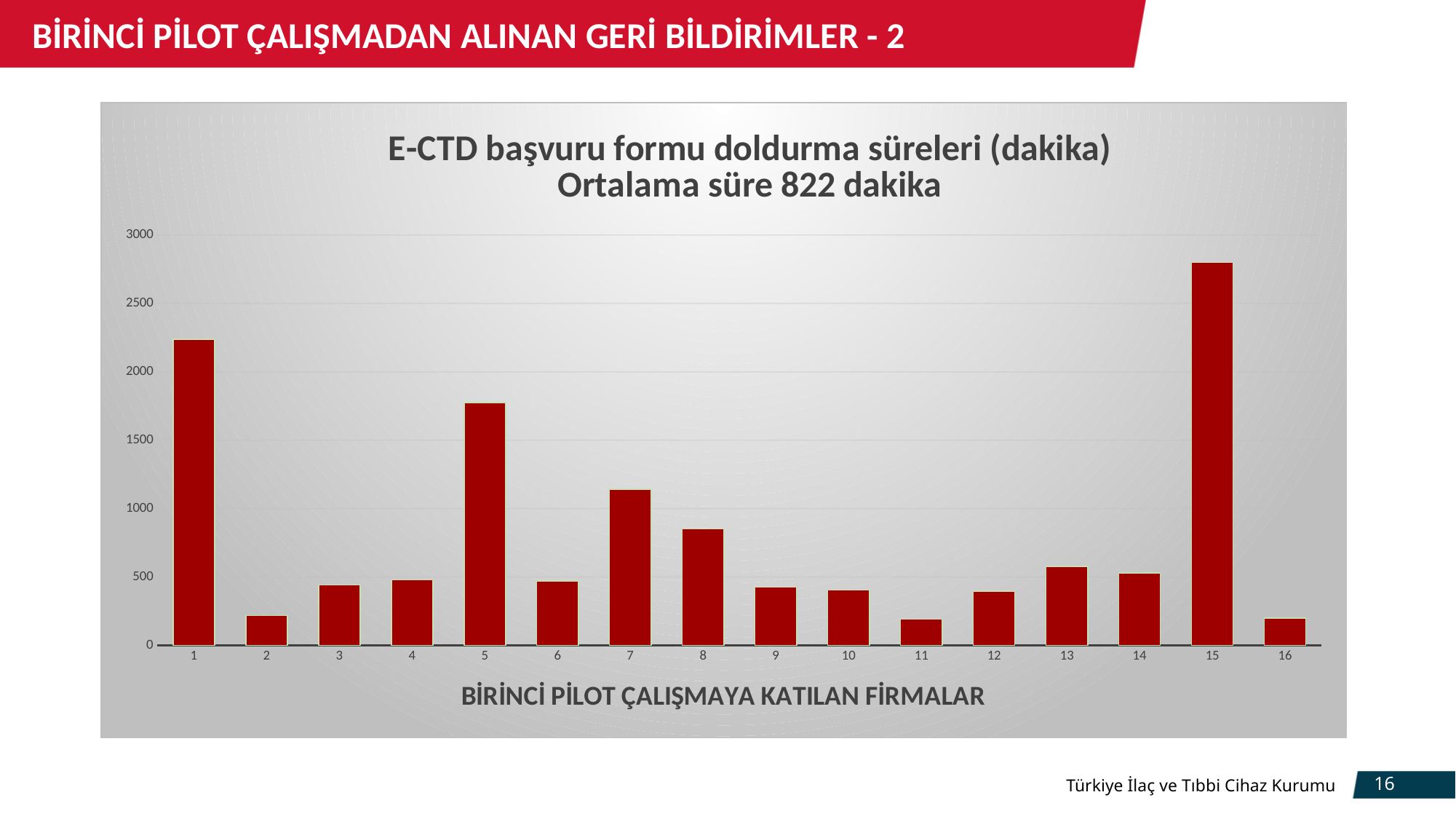
Which firm has the highest E-CTD form completion time? 15 Is the value for firm 15 greater or less than 2500? greater How many firms (categories) are shown on the x axis of the chart? 16 Which has a larger value, firm 7 or firm 8? firm 7 Is the value for firm 1 greater or less than 2000? greater What kind of chart is shown on the slide? bar chart Is the value for firm 8 greater or less than 1000? less According to the chart title, what is the average (ortalama) form completion time? 822 dakika What is the title of the x axis of the chart? BİRİNCİ PİLOT ÇALIŞMAYA KATILAN FİRMALAR Which has a larger value, firm 1 or firm 5? firm 1